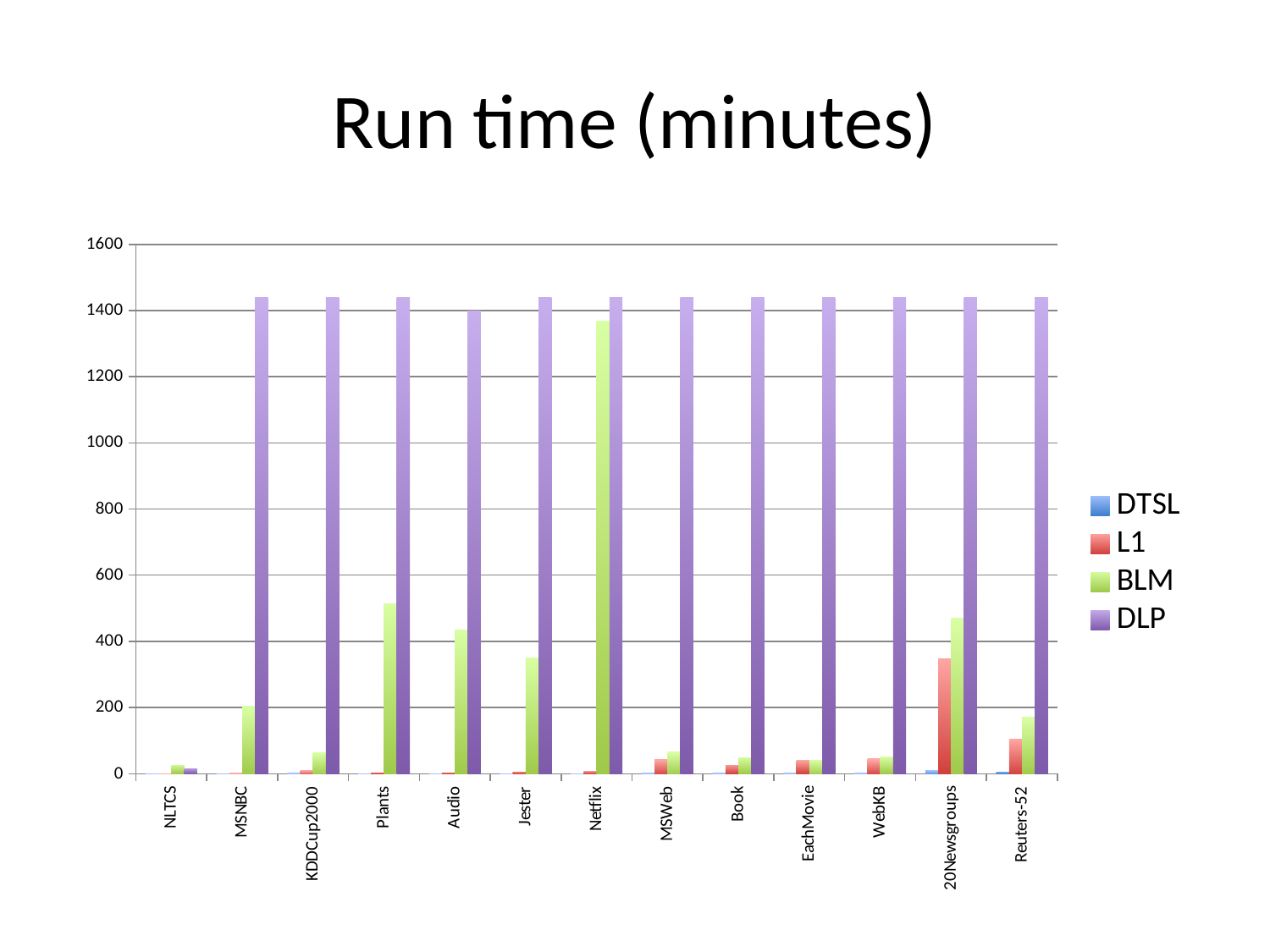
Is the L1 value for 20Newsgroups greater or less than 200? greater Is the BLM value for Plants greater or less than 400? greater Which is larger, the L1 value for 20Newsgroups or the L1 value for Reuters-52? 20Newsgroups Is the BLM value for Netflix greater or less than 1200? greater Which category has the lowest DLP value? NLTCS What is the title of the chart? Run time (minutes) How many categories (datasets) are shown on the x axis? 13 How many series does the legend list? 4 Which category has the highest BLM value? Netflix What kind of chart is shown on the slide? bar chart Which is larger, the BLM value for Plants or the BLM value for MSNBC? Plants